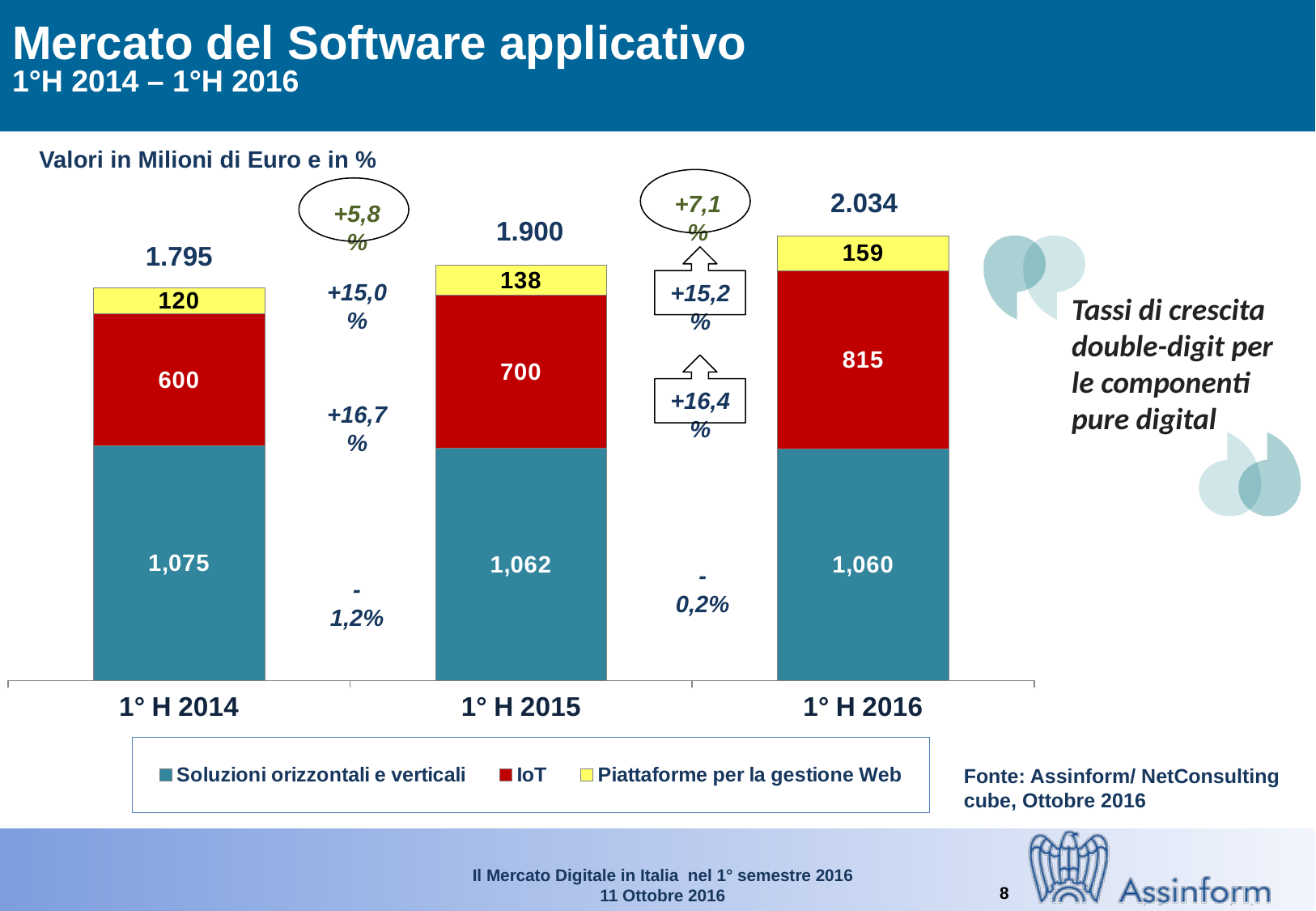
What is the total of the stacked bar for 1° H 2014? 1.795 What is the total of the stacked bar for 1° H 2016? 2.034 What is the value of Soluzioni orizzontali e verticali in 1° H 2014? 1,075 Which period has the highest IoT value? 1° H 2016 What kind of chart is shown on the slide? Stacked bar chart Which period has the lowest value for Piattaforme per la gestione Web? 1° H 2014 How many series does the legend list? 3 How many periods are shown on the x axis? 3 What is the IoT value for 1° H 2015? 700 Which is larger: Soluzioni orizzontali e verticali in 1° H 2015 or in 1° H 2016? 1° H 2015 What is the value of Piattaforme per la gestione Web in 1° H 2016? 159 What is the difference between the IoT values for 1° H 2016 and 1° H 2014? 215